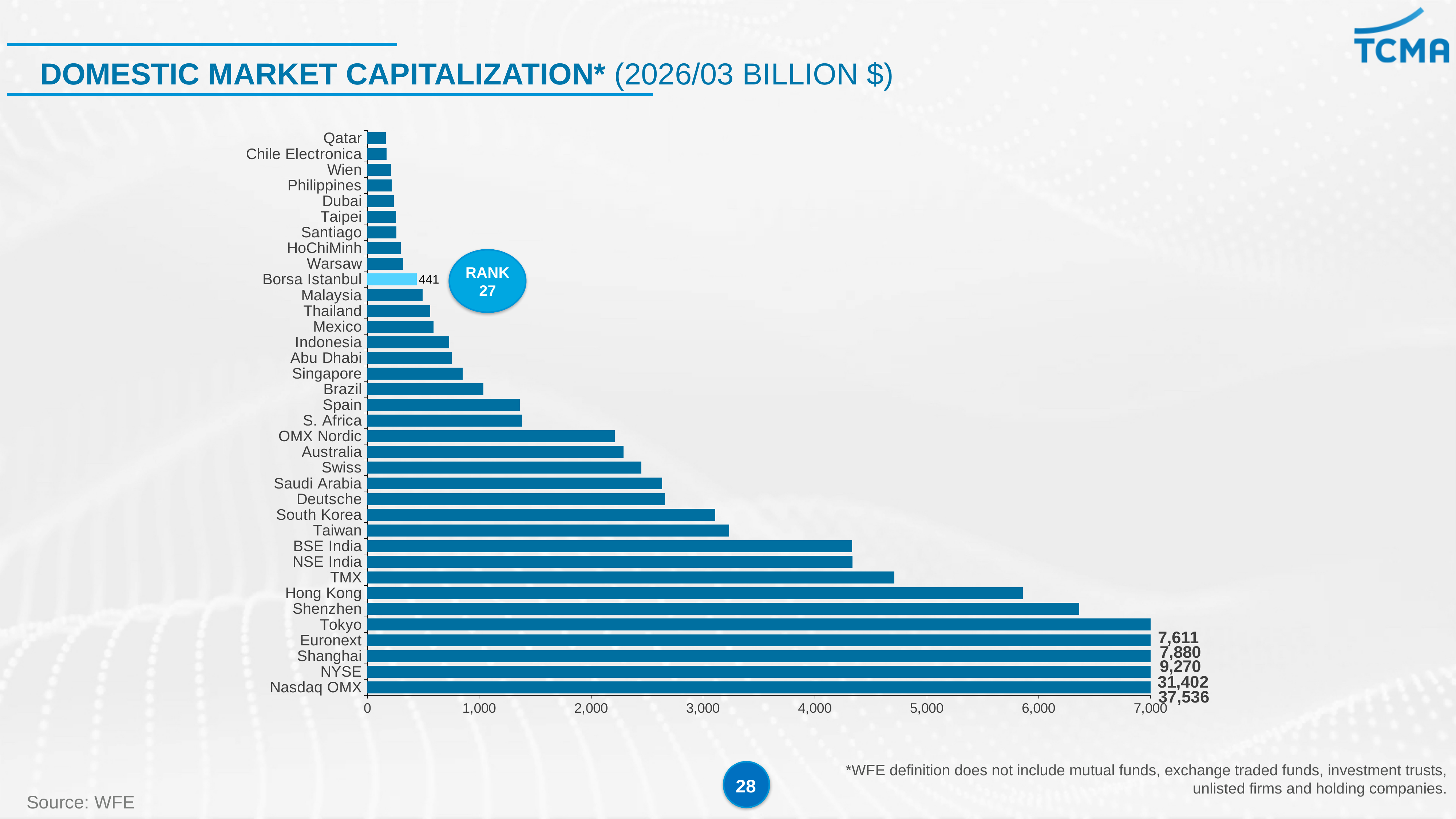
What rank is shown in the callout next to Borsa Istanbul? 27 Is the value for Singapore greater or less than 1,000? less Is the value for Hong Kong greater or less than 5,000? greater What is the value shown for NYSE? 31,402 What kind of chart is shown on the slide? bar chart How many exchanges are listed in the chart? 36 Which exchange has the highest domestic market capitalization? Nasdaq OMX What is the difference between the values for Nasdaq OMX and NYSE? 6,134 Which has a larger value, Hong Kong or Shenzhen? Shenzhen What is the domestic market capitalization value shown for Borsa Istanbul? 441 What is the value shown for Nasdaq OMX? 37,536 Is the value for Australia greater or less than 2,000? greater